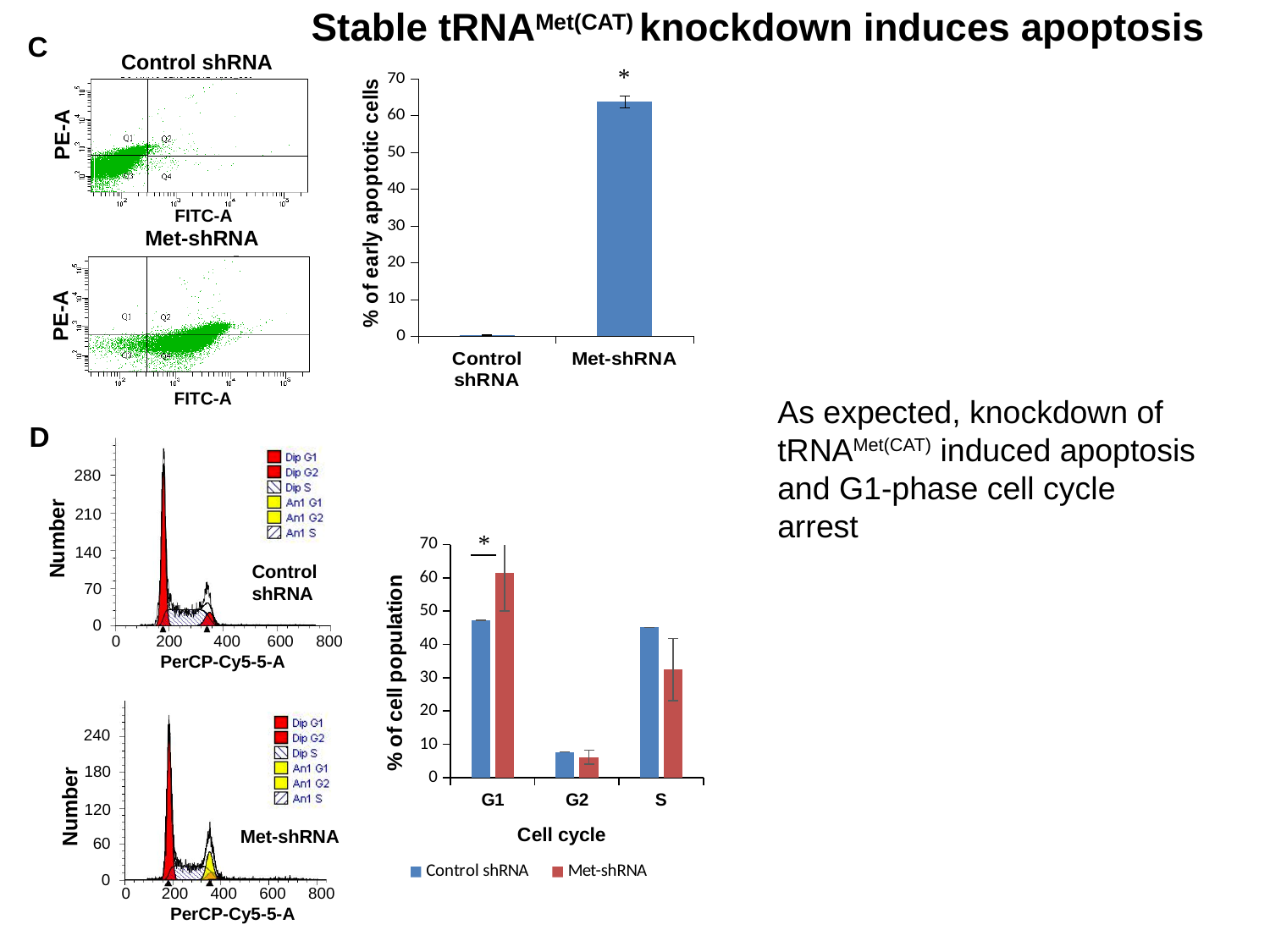
In the bar chart in panel C (% of early apoptotic cells), is the value for Met-shRNA greater or less than 60? greater How many cell cycle categories are shown on the x axis of the bar chart in panel D (% of cell population)? 3 In the bar chart in panel C (% of early apoptotic cells), is the value for Control shRNA greater or less than 10? less What is the y-axis label of the bar chart in panel C? % of early apoptotic cells In the bar chart in panel C (% of early apoptotic cells), which category has the higher value? Met-shRNA In the bar chart in panel D (% of cell population), which is larger for G1: Control shRNA or Met-shRNA? Met-shRNA What kind of chart is the chart in panel C showing % of early apoptotic cells? bar chart In the bar chart in panel D (% of cell population), which is larger for S: Control shRNA or Met-shRNA? Control shRNA How many series does the legend list for the bar chart in panel D (% of cell population)? 2 In the bar chart in panel D (% of cell population), which cell cycle phase has the lowest Met-shRNA value? G2 In the bar chart in panel D (% of cell population), is the Control shRNA value for G2 greater or less than 20? less How many categories are shown on the x axis of the bar chart in panel C (% of early apoptotic cells)? 2